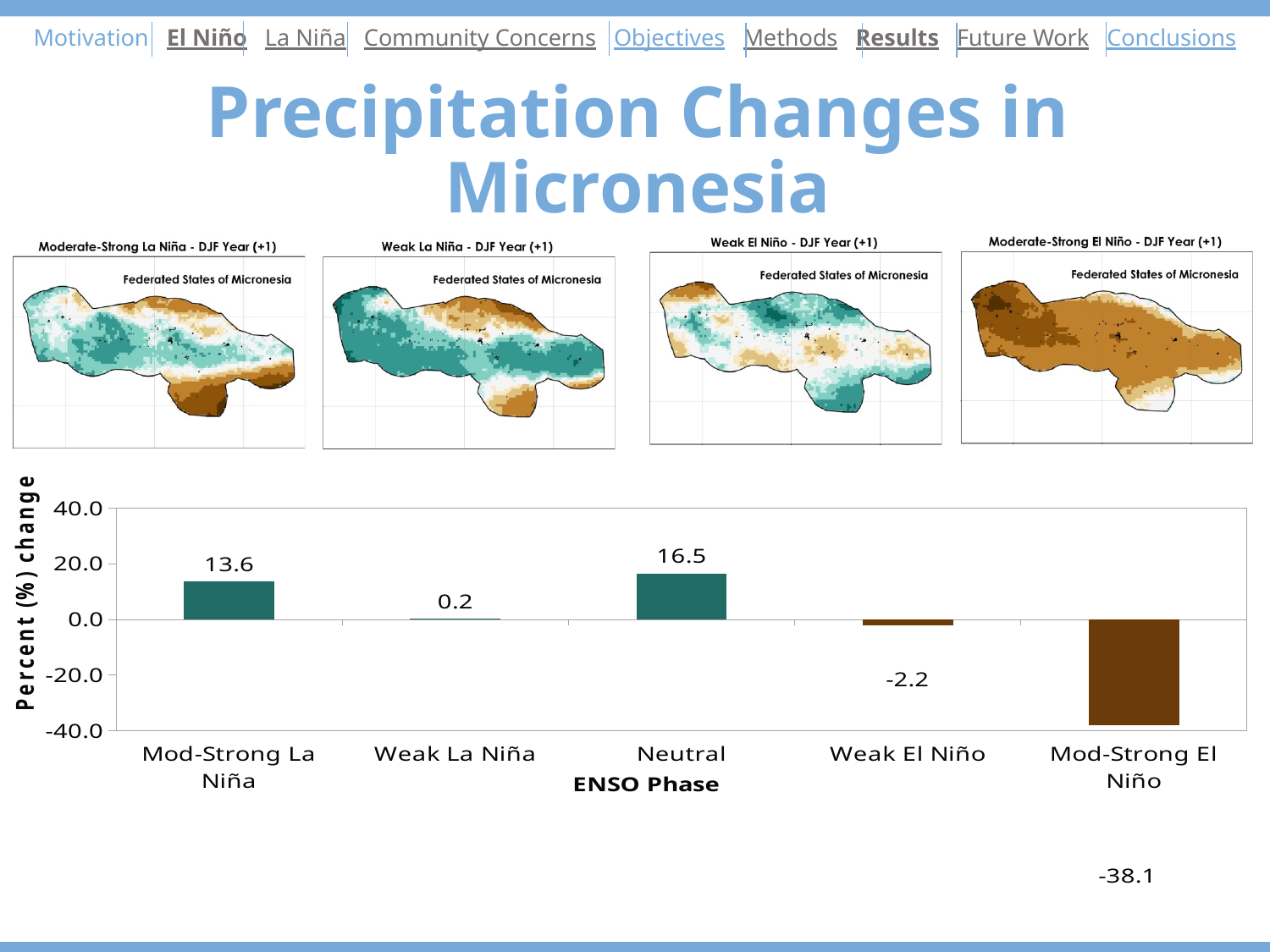
What is the difference between the percent change for Neutral and for Mod-Strong La Niña? 2.9 What is the percent change for Mod-Strong El Niño in the bar chart? -38.1 Which ENSO phase has the highest percent change in the bar chart? Neutral What is the label of the x axis of the bar chart? ENSO Phase Which ENSO phase has the lowest percent change in the bar chart? Mod-Strong El Niño Which has a larger percent change, Weak La Niña or Weak El Niño? Weak La Niña What is the label of the y axis of the bar chart? Percent (%) change What is the percent change for Neutral in the bar chart? 16.5 What kind of chart is used to show percent change by ENSO phase? Bar chart What is the percent change for Mod-Strong La Niña in the bar chart? 13.6 What is the percent change for Weak El Niño in the bar chart? -2.2 How many ENSO phases are shown on the x axis of the bar chart? 5